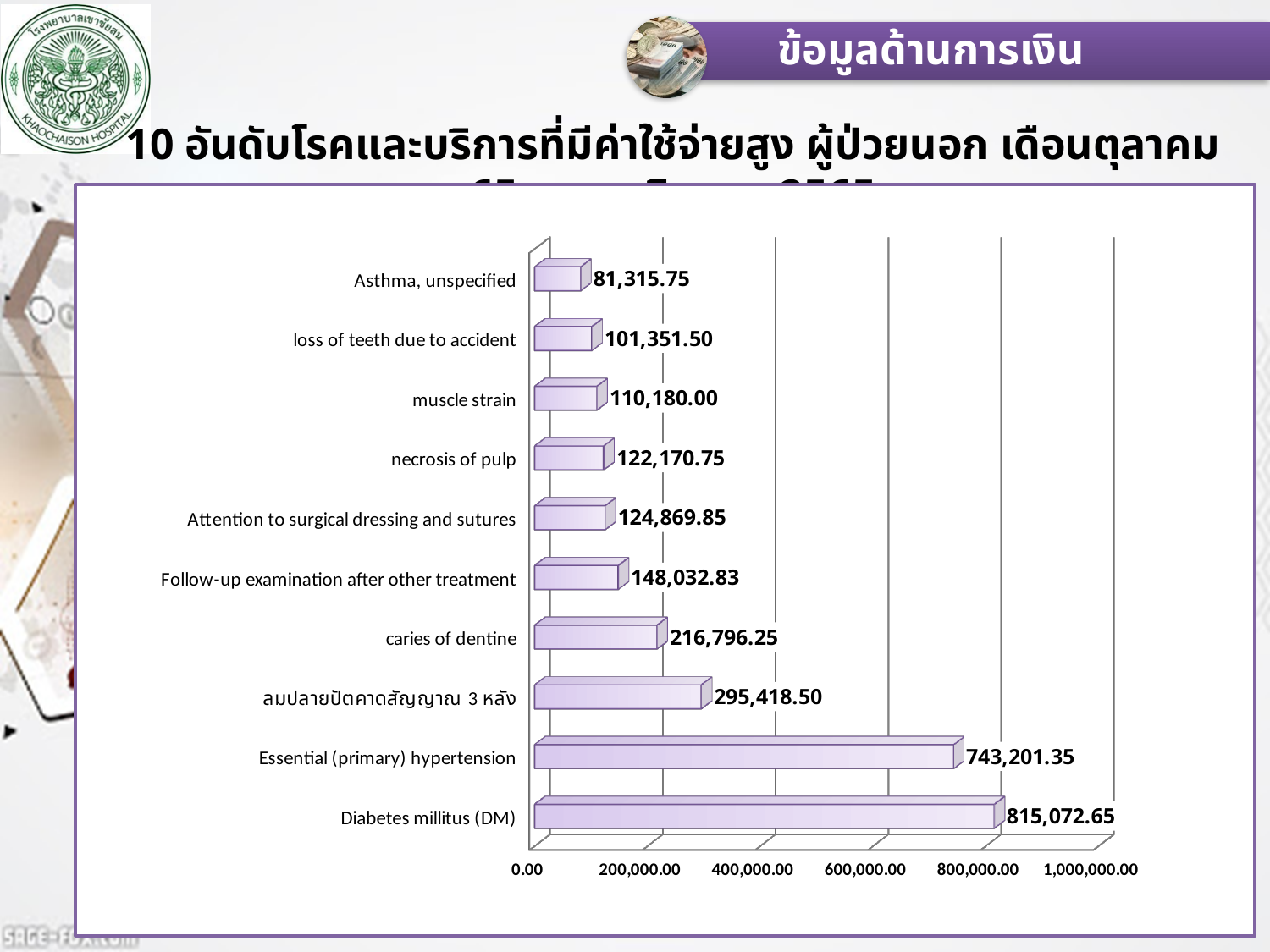
Which category has the highest value? Diabetes millitus (DM) Is the value for Essential (primary) hypertension greater or less than 600,000.00? greater What is the value for Follow-up examination after other treatment? 148,032.83 What is the value for Asthma, unspecified? 81,315.75 Which category has the lowest value? Asthma, unspecified What is the difference between the values for Diabetes millitus (DM) and Essential (primary) hypertension? 71,871.30 Which is larger, the value for muscle strain or the value for necrosis of pulp? necrosis of pulp How many categories are shown in the chart? 10 What is the value for Diabetes millitus (DM)? 815,072.65 What is the value for Essential (primary) hypertension? 743,201.35 What is the value for caries of dentine? 216,796.25 What kind of chart is shown on the slide? bar chart